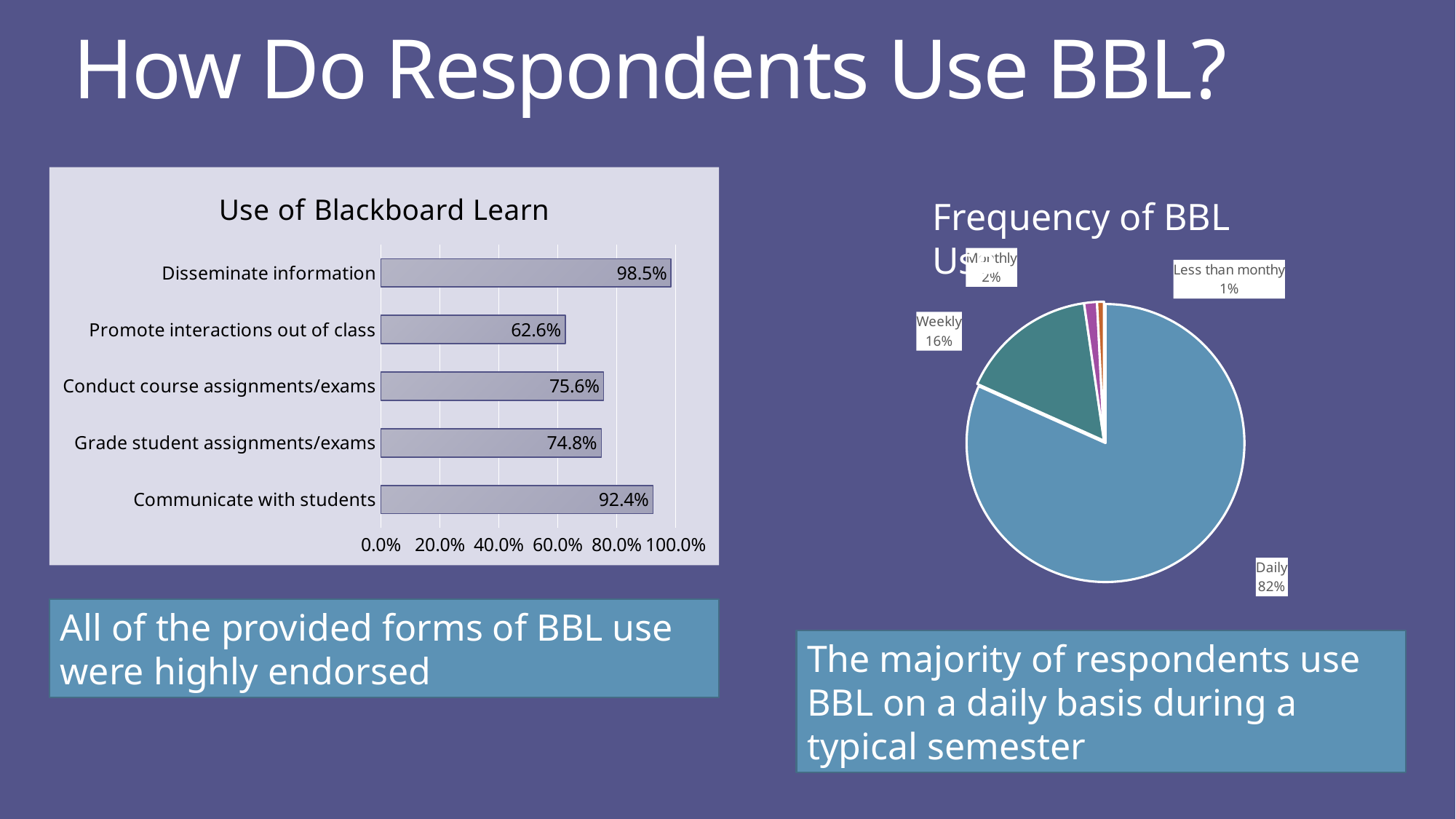
What kind of chart is the 'Use of Blackboard Learn' chart? Bar chart In the 'Use of Blackboard Learn' chart, what is the value for Promote interactions out of class? 62.6% In the 'Use of Blackboard Learn' chart, what is the value for Disseminate information? 98.5% How many categories are shown in the 'Use of Blackboard Learn' chart? 5 In the pie chart on the right, what share of respondents use BBL Weekly? 16% In the pie chart on the right, what share of respondents use BBL Daily? 82% In the 'Use of Blackboard Learn' chart, which category has the lowest value? Promote interactions out of class In the 'Use of Blackboard Learn' chart, what is the difference between Disseminate information and Communicate with students? 6.1% In the pie chart on the right, which slice is the smallest? Less than monthly In the 'Use of Blackboard Learn' chart, which category has the highest value? Disseminate information In the 'Use of Blackboard Learn' chart, which is larger: Conduct course assignments/exams or Grade student assignments/exams? Conduct course assignments/exams In the 'Use of Blackboard Learn' chart, what is the value for Communicate with students? 92.4%